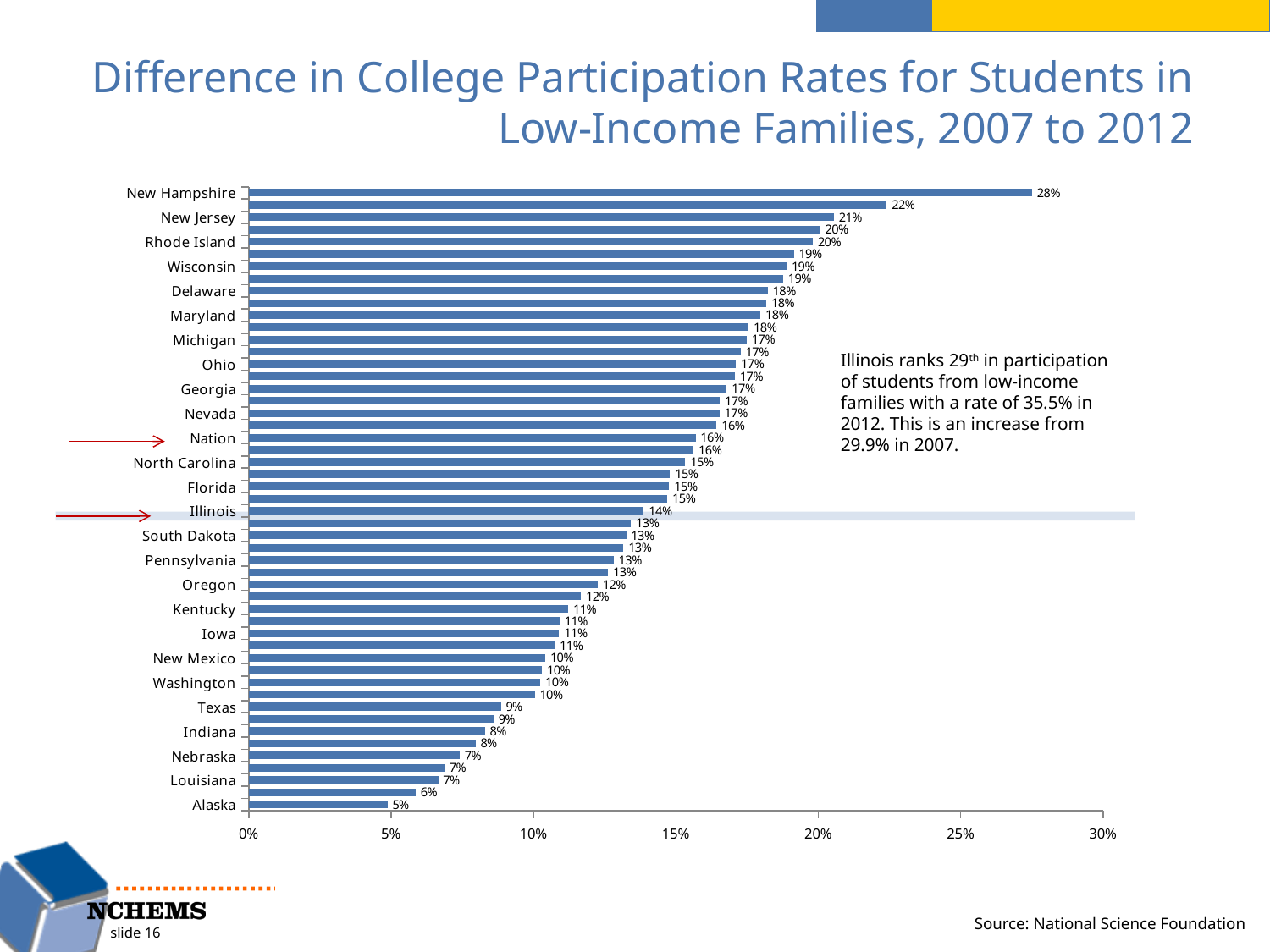
Which has a larger value, New Jersey or Oregon? New Jersey What is the value shown for the Nation bar? 16% Which labeled category has the lowest value? Alaska What is the value shown for New Hampshire? 28% What is the value shown for Alaska? 5% What is the difference between the Nation value and the Illinois value? 2 percentage points What kind of chart is shown on the slide? Bar chart What is the title of the chart? Difference in College Participation Rates for Students in Low-Income Families, 2007 to 2012 Which labeled category has the highest value? New Hampshire Is the value for Texas greater or less than 10%? less What is the value shown for Illinois? 14% What is the difference between the values for New Hampshire and Alaska? 23 percentage points